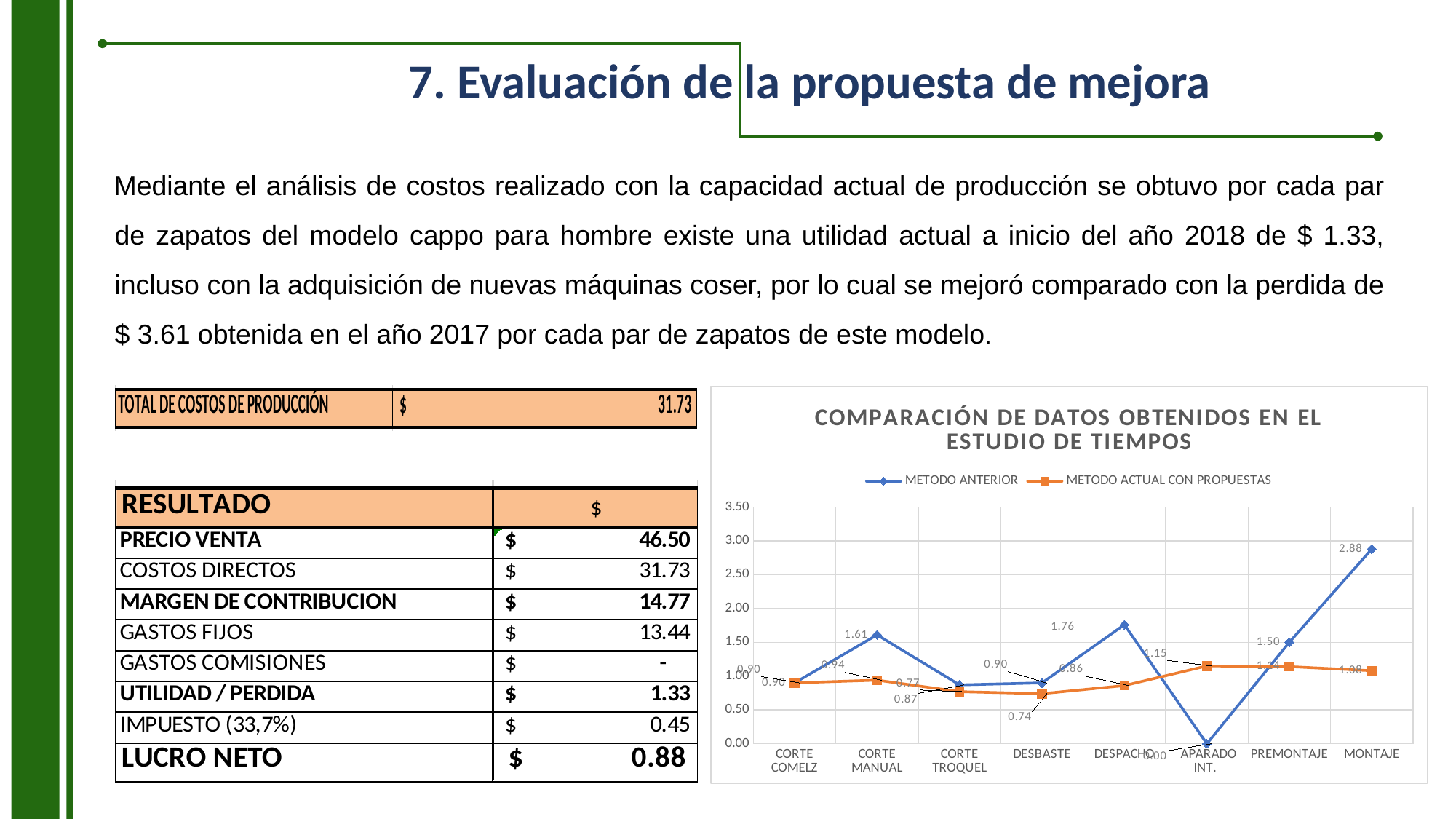
What is the difference between METODO ANTERIOR and METODO ACTUAL CON PROPUESTAS at MONTAJE? 1.80 How many categories are shown on the x axis of the chart? 8 What kind of chart is shown on the slide? line chart Which category has the highest value for METODO ANTERIOR? MONTAJE What is the value for METODO ACTUAL CON PROPUESTAS at MONTAJE? 1.08 What is the title of the chart? COMPARACIÓN DE DATOS OBTENIDOS EN EL ESTUDIO DE TIEMPOS At DESPACHO, which series has the larger value, METODO ANTERIOR or METODO ACTUAL CON PROPUESTAS? METODO ANTERIOR What is the value for METODO ANTERIOR at MONTAJE? 2.88 How many series does the chart legend list? 2 Which category has the lowest value for METODO ANTERIOR? APARADO INT. What is the value for METODO ACTUAL CON PROPUESTAS at APARADO INT.? 1.15 What is the value for METODO ANTERIOR at CORTE MANUAL? 1.61